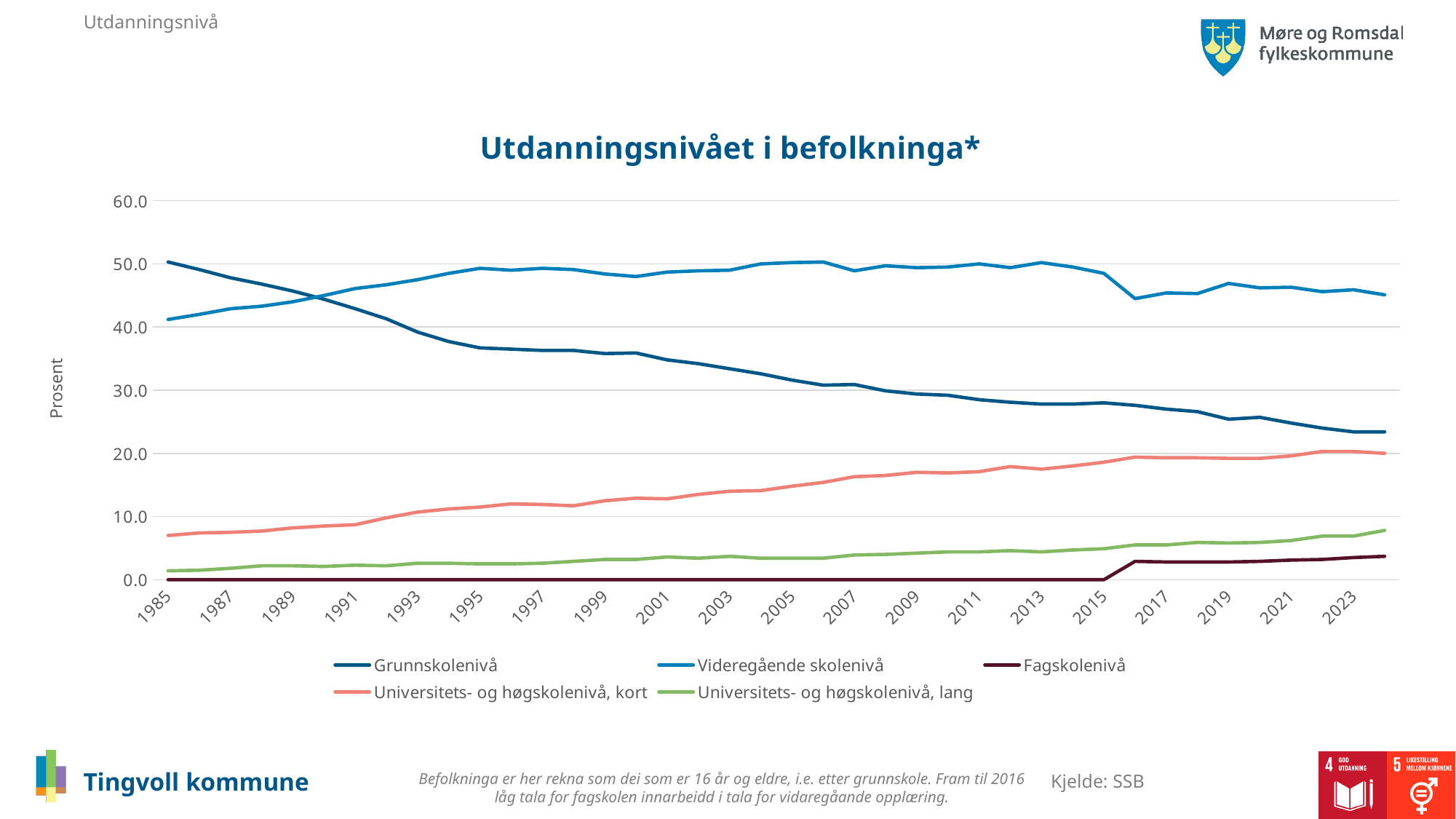
Is the value for Fagskolenivå in 2023 greater or less than 10.0? less In 2023, which is larger: Grunnskolenivå or Videregående skolenivå? Videregående skolenivå How many series does the legend list? 5 What is the label on the vertical axis? Prosent Which series has the lowest value in 2023? Fagskolenivå In 1985, which is larger: Grunnskolenivå or Videregående skolenivå? Grunnskolenivå What is the title of the chart? Utdanningsnivået i befolkninga* What kind of chart is shown on the slide? line chart Which series has the highest value in 2023? Videregående skolenivå Is the value for Grunnskolenivå in 1985 greater or less than 40.0? greater Does the Universitets- og høgskolenivå, kort line rise or fall from 1985 to 2023? rise Does the Grunnskolenivå line rise or fall from 1985 to 2023? fall